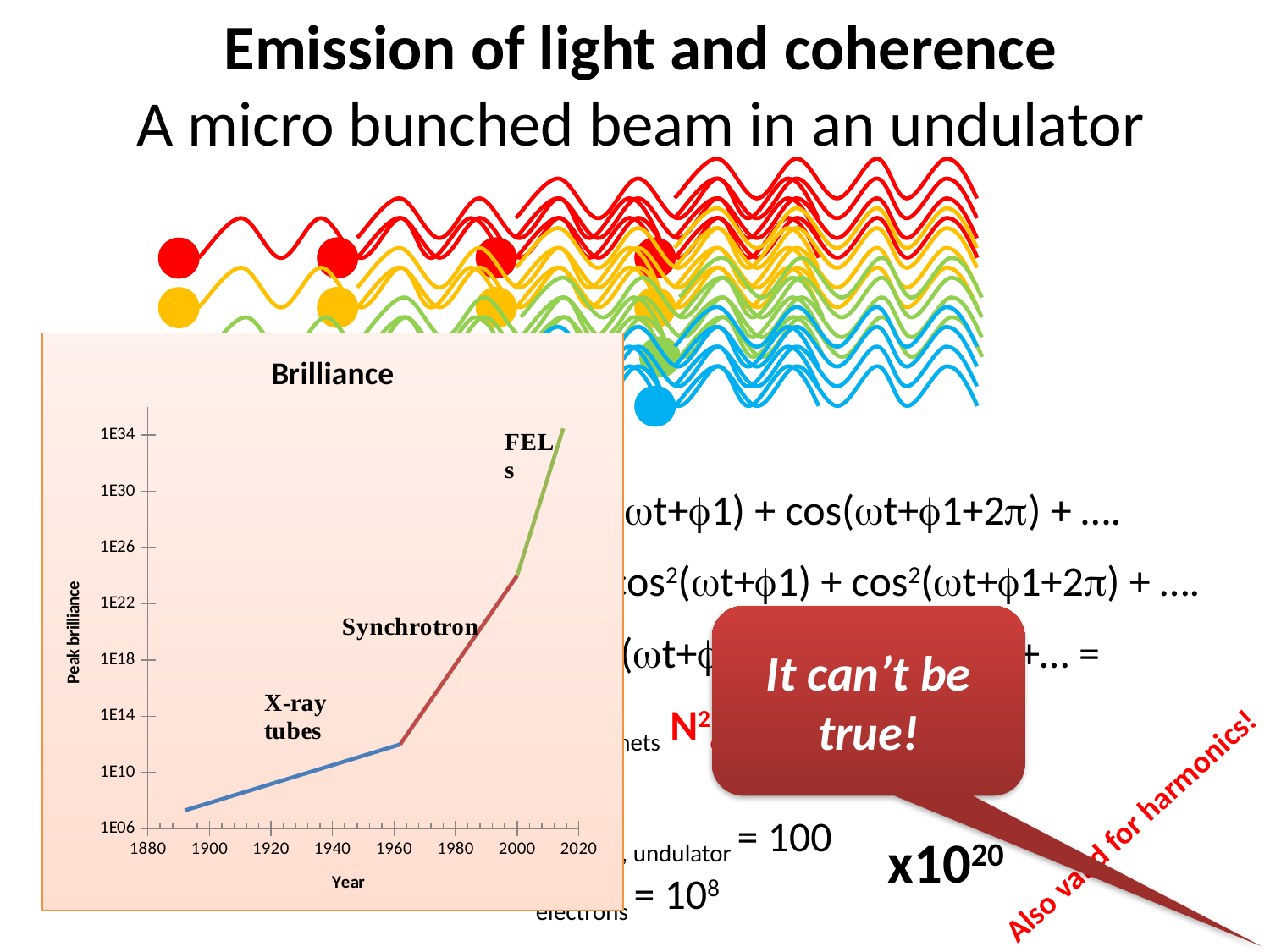
In the Brilliance chart, is the peak brilliance around 2000 greater or less than 1E22? greater Do the values in the Brilliance chart rise or fall as the year increases? rise What kind of chart is the Brilliance chart? line chart What is the label of the x axis of the Brilliance chart? Year In the Brilliance chart, is the peak brilliance around 2000 greater or less than 1E26? less In the Brilliance chart, is the peak brilliance at the earliest plotted year greater or less than 1E10? less In the Brilliance chart, which labelled segment reaches the highest peak brilliance? FELs How many labelled technology segments are shown on the Brilliance chart? 3 In the Brilliance chart, which labelled segment has the lowest peak brilliance? X-ray tubes What is the title of the chart on the slide? Brilliance